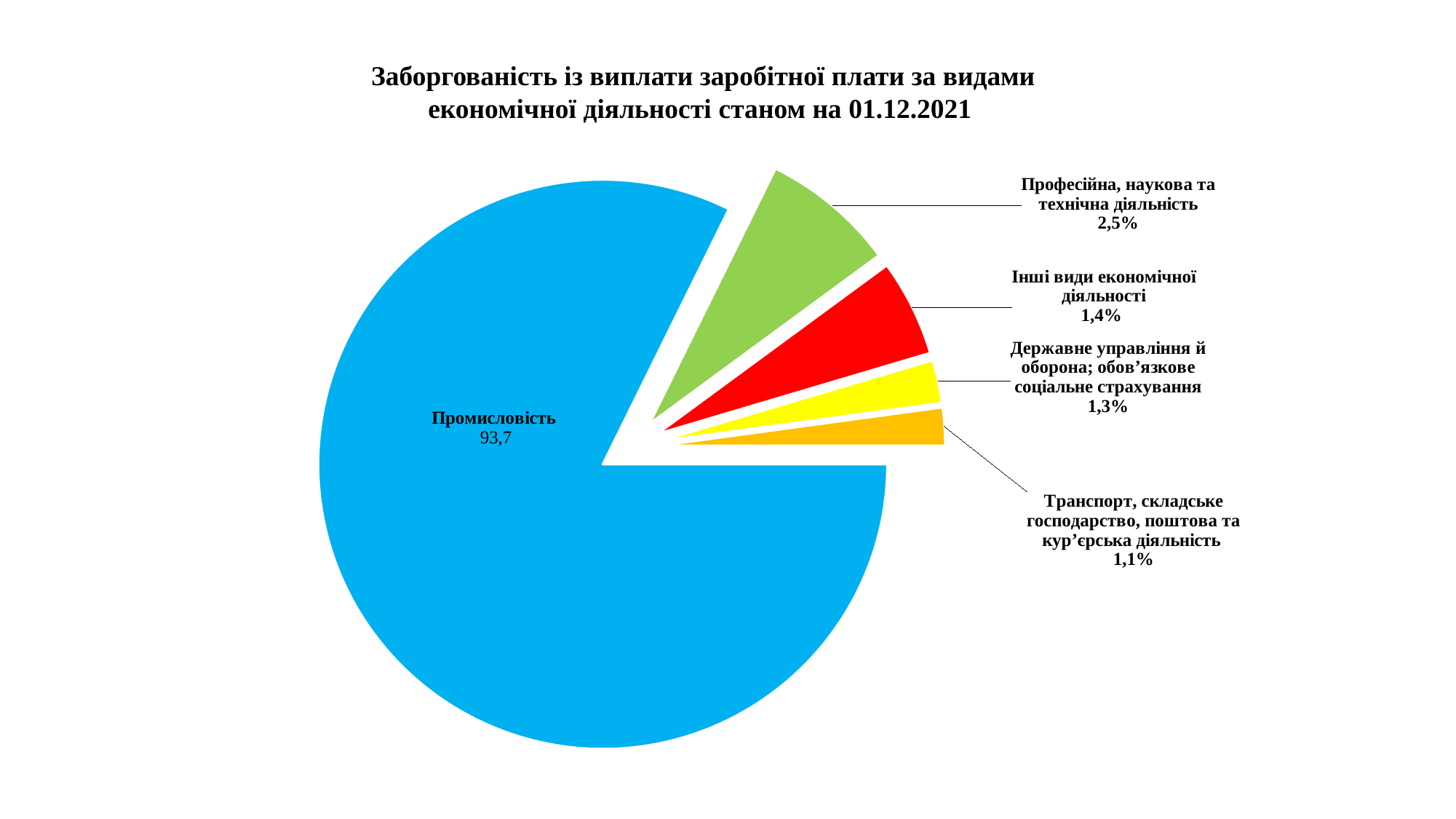
Which category has the largest slice of the pie? Промисловість How many slices does the pie chart have? 5 What kind of chart is shown on the slide? pie chart What is the title of the chart? Заборгованість із виплати заробітної плати за видами економічної діяльності станом на 01.12.2021 Which category has the smallest slice of the pie? Транспорт, складське господарство, поштова та кур'єрська діяльність What share is shown for Професійна, наукова та технічна діяльність? 2,5% What share is shown for Інші види економічної діяльності? 1,4% Which is larger: the share for Інші види економічної діяльності or for Державне управління й оборона; обов'язкове соціальне страхування? Інші види економічної діяльності What share is shown for Транспорт, складське господарство, поштова та кур'єрська діяльність? 1,1% What colour is the slice for Промисловість? blue What value is shown for Промисловість? 93,7 What share is shown for Державне управління й оборона; обов'язкове соціальне страхування? 1,3%